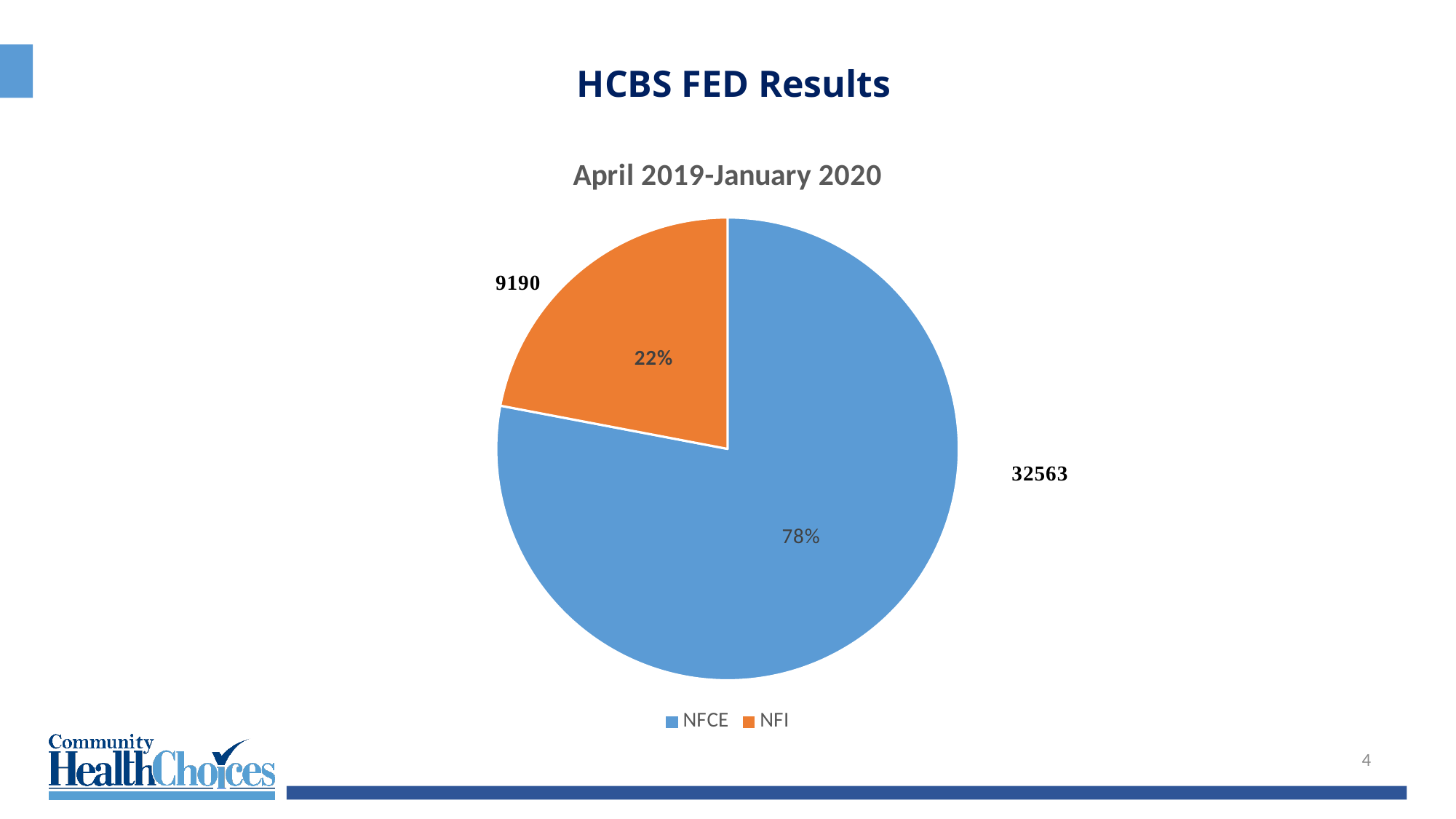
What is the title of the chart? April 2019-January 2020 How many slices does the pie chart have? 2 Which is larger, NFCE or NFI? NFCE Which category has the largest slice? NFCE What percentage share of the pie does NFCE have? 78% What is the difference between the NFCE value and the NFI value? 23373 What is the value for NFCE? 32563 What is the total of the two slices in the pie chart? 41753 What type of chart is shown on the slide? pie chart Which category has the smallest slice? NFI What is the value for NFI? 9190 What percentage share of the pie does NFI have? 22%